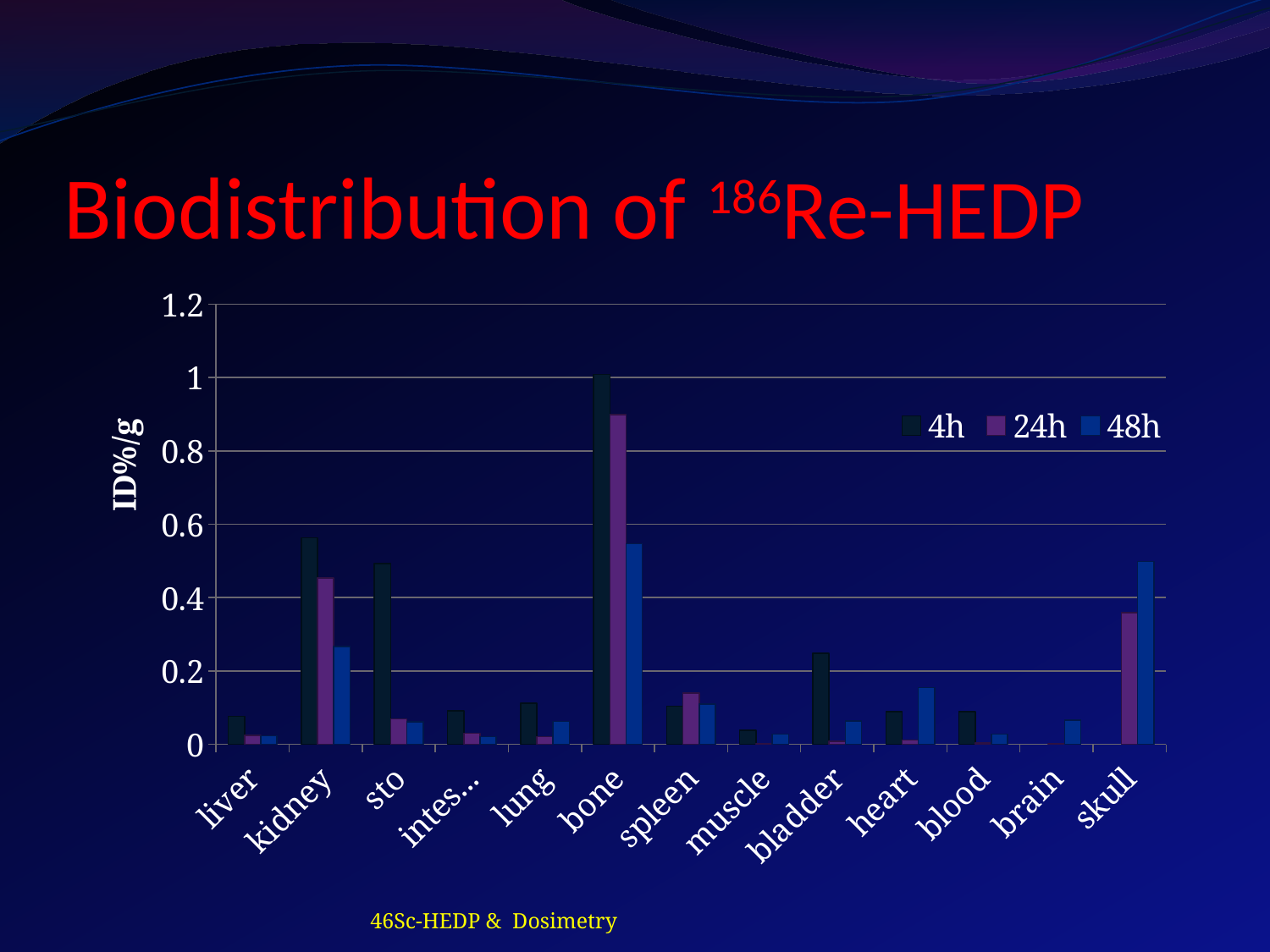
What kind of chart is shown on the slide? bar chart Is the 4h value for kidney greater or less than 0.4? greater For bone, which is larger: the 24h value or the 48h value? 24h Which organ has the highest 4h value? bone For kidney, which is larger: the 4h value or the 24h value? 4h How many series does the legend list? 3 Is the 4h value for bone greater or less than 0.8? greater Is the 4h value for bladder greater or less than 0.2? greater How many organ categories are shown on the x axis? 13 What is the label on the y axis? ID%/g For skull, which is larger: the 24h value or the 48h value? 48h